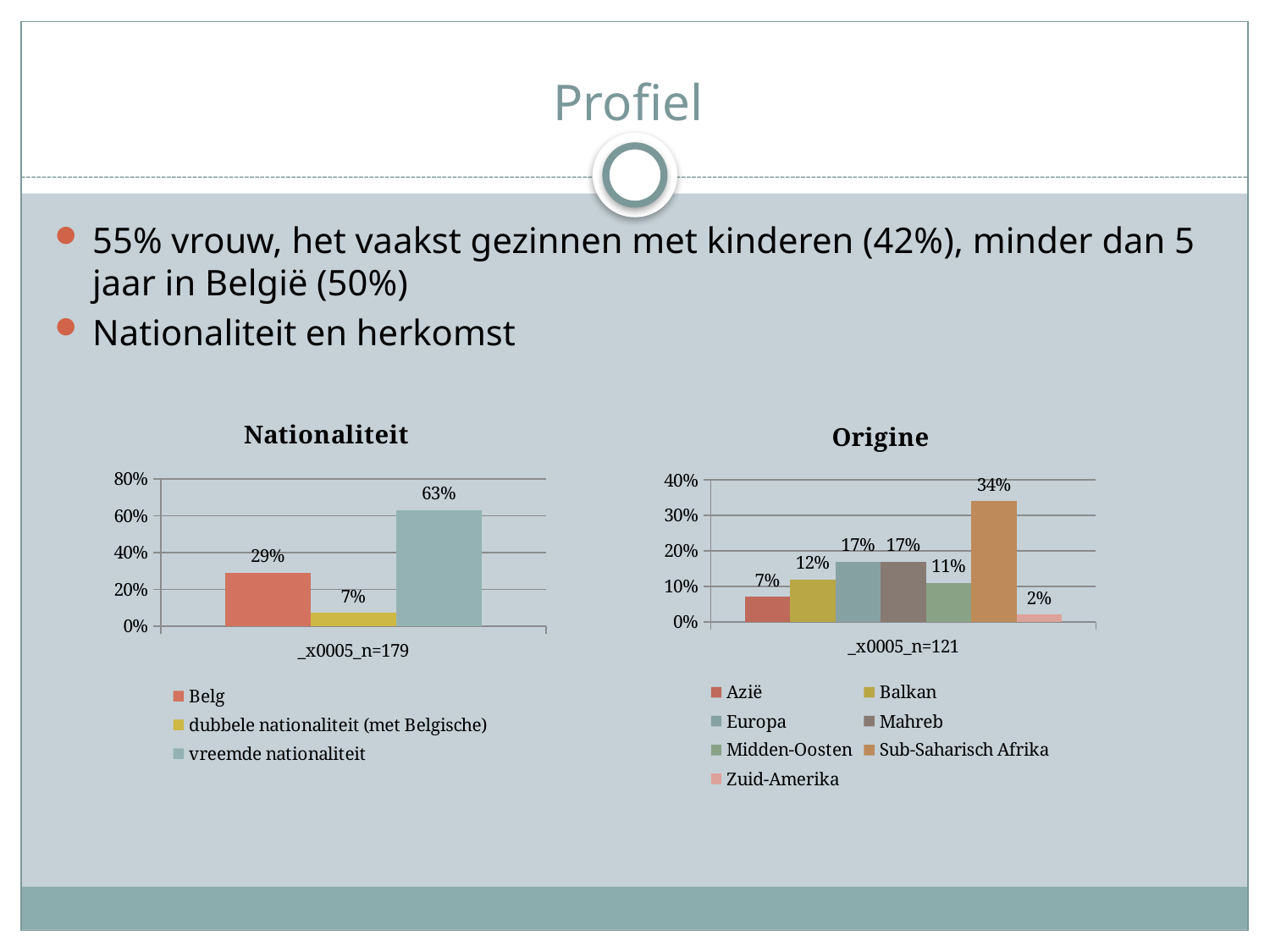
In the Origine chart, which series has the lowest value? Zuid-Amerika In the Nationaliteit chart, what is the value for Belg? 29% In the Origine chart, what is the difference between Sub-Saharisch Afrika and Europa? 17% In the Nationaliteit chart, how many series does the legend list? 3 In the Origine chart, how many series does the legend list? 7 In the Nationaliteit chart, which series has the lowest value? dubbele nationaliteit (met Belgische) In the Origine chart, what is the value for Sub-Saharisch Afrika? 34% In the Origine chart, which is larger: Balkan or Azië? Balkan In the Nationaliteit chart, what is the difference between vreemde nationaliteit and Belg? 34% In the Origine chart, what is the value for Midden-Oosten? 11% In the Nationaliteit chart, what is the value for vreemde nationaliteit? 63% What kind of chart is the Origine chart? bar chart